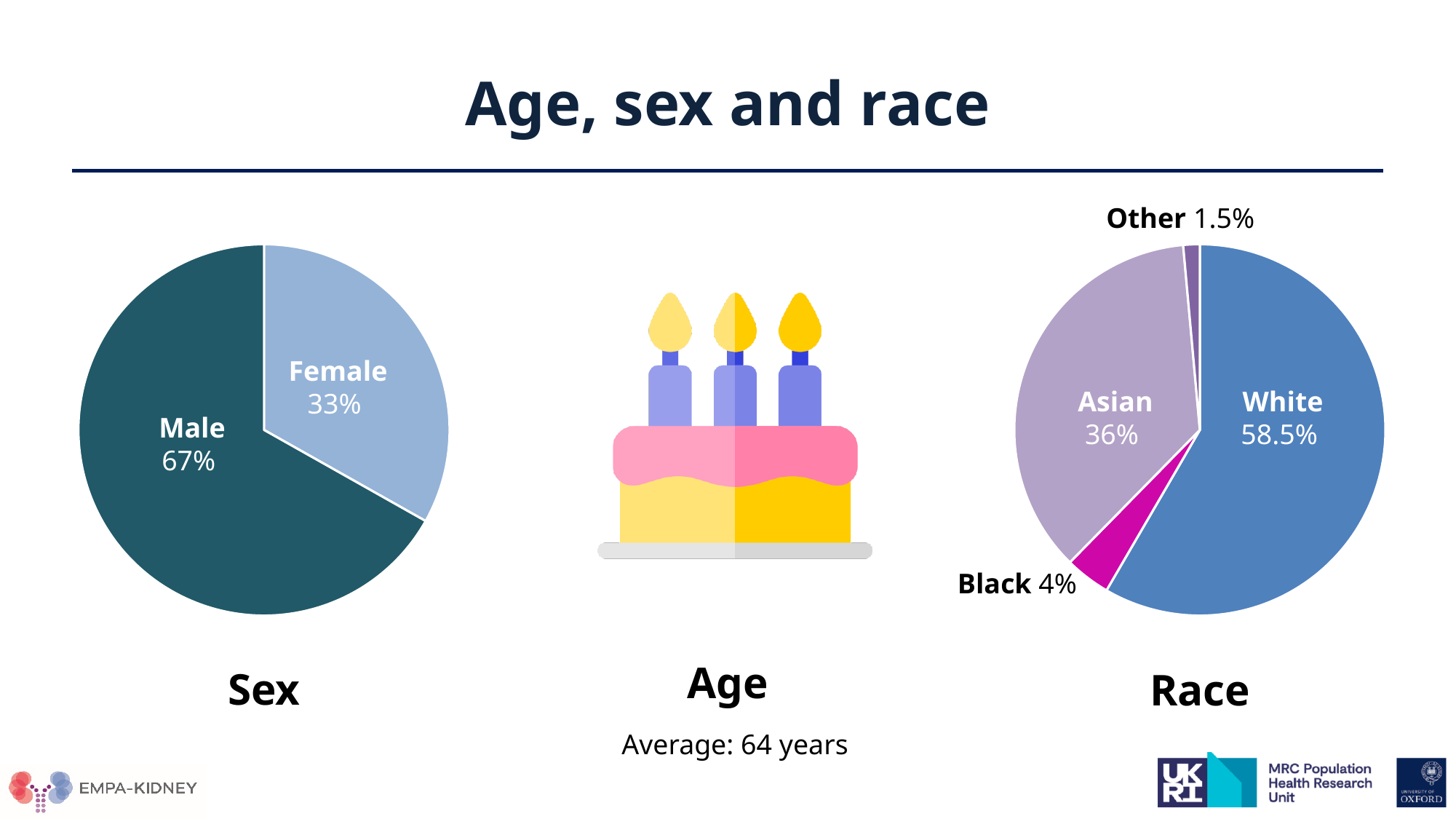
In the Race pie chart, what percentage is Asian? 36% In the Sex pie chart, what percentage is Female? 33% In the Race pie chart, what percentage is Other? 1.5% In the Race pie chart, what percentage is Black? 4% In the Sex pie chart, what is the difference between the Male and Female percentages? 34% In the Race pie chart, which category has the largest share? White In the Race pie chart, which category has the smallest share? Other In the Race pie chart, what percentage is White? 58.5% In the Race pie chart, which is larger, the Asian share or the Black share? Asian How many categories are shown in the Race pie chart? 4 What type of chart is used for Sex and Race on this slide? Pie chart In the Sex pie chart, what percentage is Male? 67%